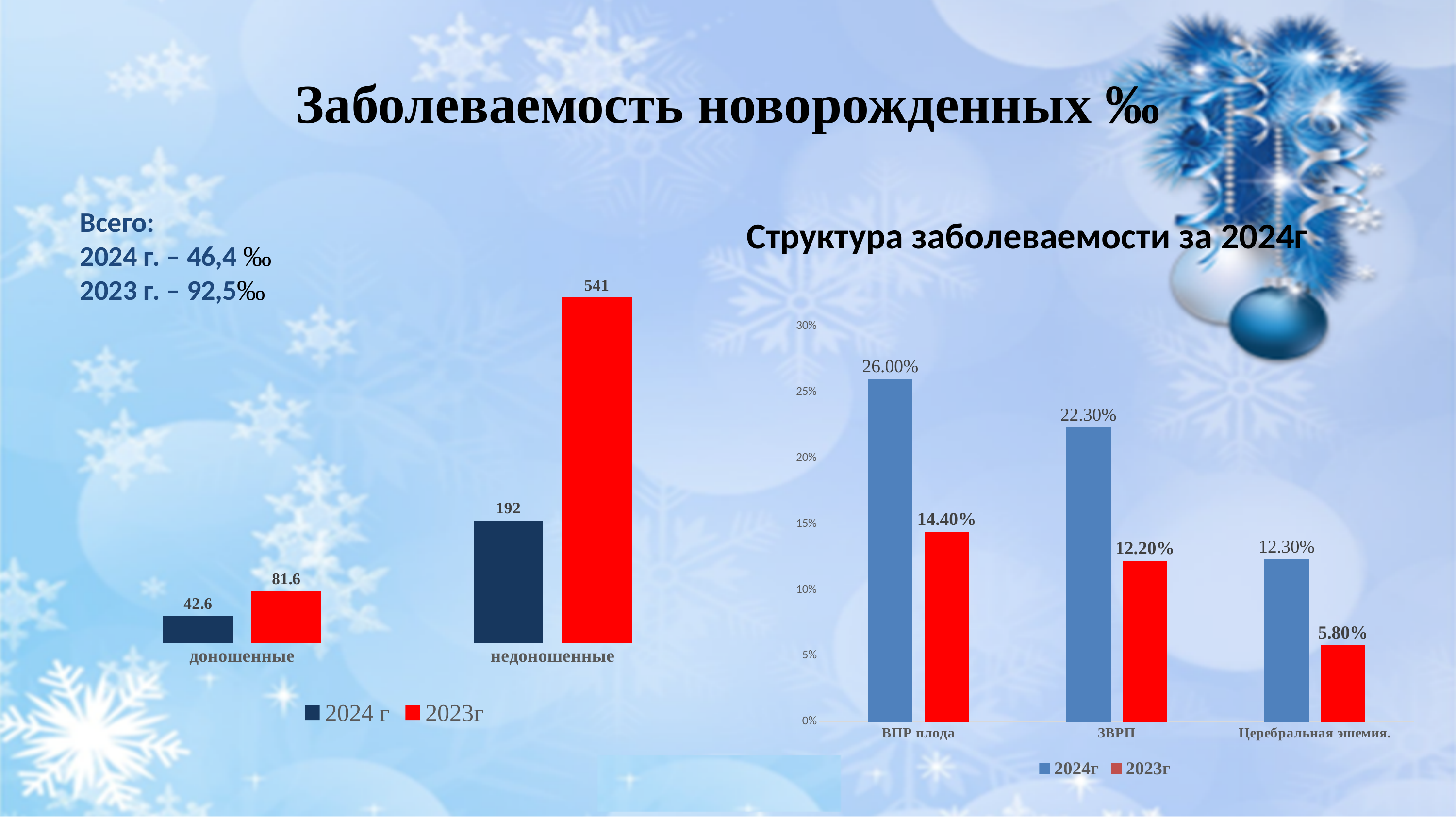
On the left chart, what is the value for недоношенные in the 2023г series? 541 In the chart 'Структура заболеваемости за 2024г', what is the value for Церебральная эшемия. in the 2023г series? 5.80% In the chart 'Структура заболеваемости за 2024г', what is the value for ВПР плода in the 2024г series? 26.00% On the left chart, how many series does the legend list? 2 On the left chart, what is the value for доношенные in the 2024 г series? 42.6 In the chart 'Структура заболеваемости за 2024г', how many categories are shown on the x axis? 3 In the chart 'Структура заболеваемости за 2024г', what is the difference between the 2024г and 2023г values for ЗВРП? 10.10% In the chart 'Структура заболеваемости за 2024г', which category has the lowest value in the 2024г series? Церебральная эшемия. On the left chart, what is the difference between the 2023г and 2024 г values for недоношенные? 349 On the left chart, which category has the highest value in the 2023г series? недоношенные In the chart 'Структура заболеваемости за 2024г', which is larger: the 2024г value for ЗВРП or the 2023г value for ВПР плода? the 2024г value for ЗВРП What kind of chart is the left chart? bar chart